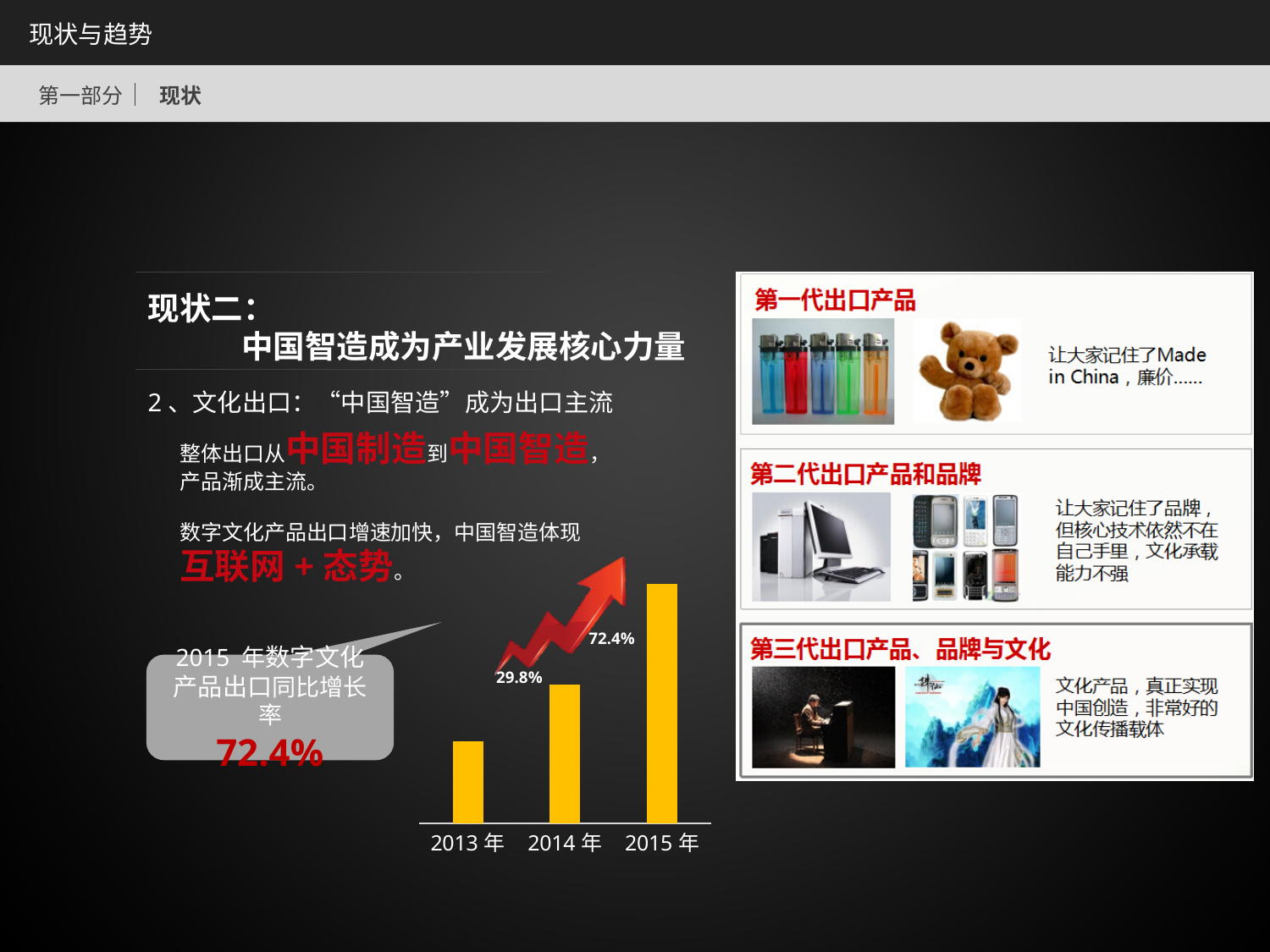
Which bar is taller, 2013 年 or 2014 年? 2014 年 What value is labelled for 2014 年 in the bar chart? 29.8% How many years are shown on the x axis of the bar chart? 3 What kind of chart is shown on the slide? bar chart What colour are the bars in the chart? yellow According to the callout next to the chart, what was the year-on-year growth rate of digital cultural product exports in 2015? 72.4% Which year has the shortest bar in the chart? 2013 年 What value is labelled for 2015 年 in the bar chart? 72.4% Which year has the tallest bar in the chart? 2015 年 Do the bar values rise or fall from 2013 年 to 2015 年? rise What is the difference between the labelled values for 2015 年 and 2014 年? 42.6 percentage points